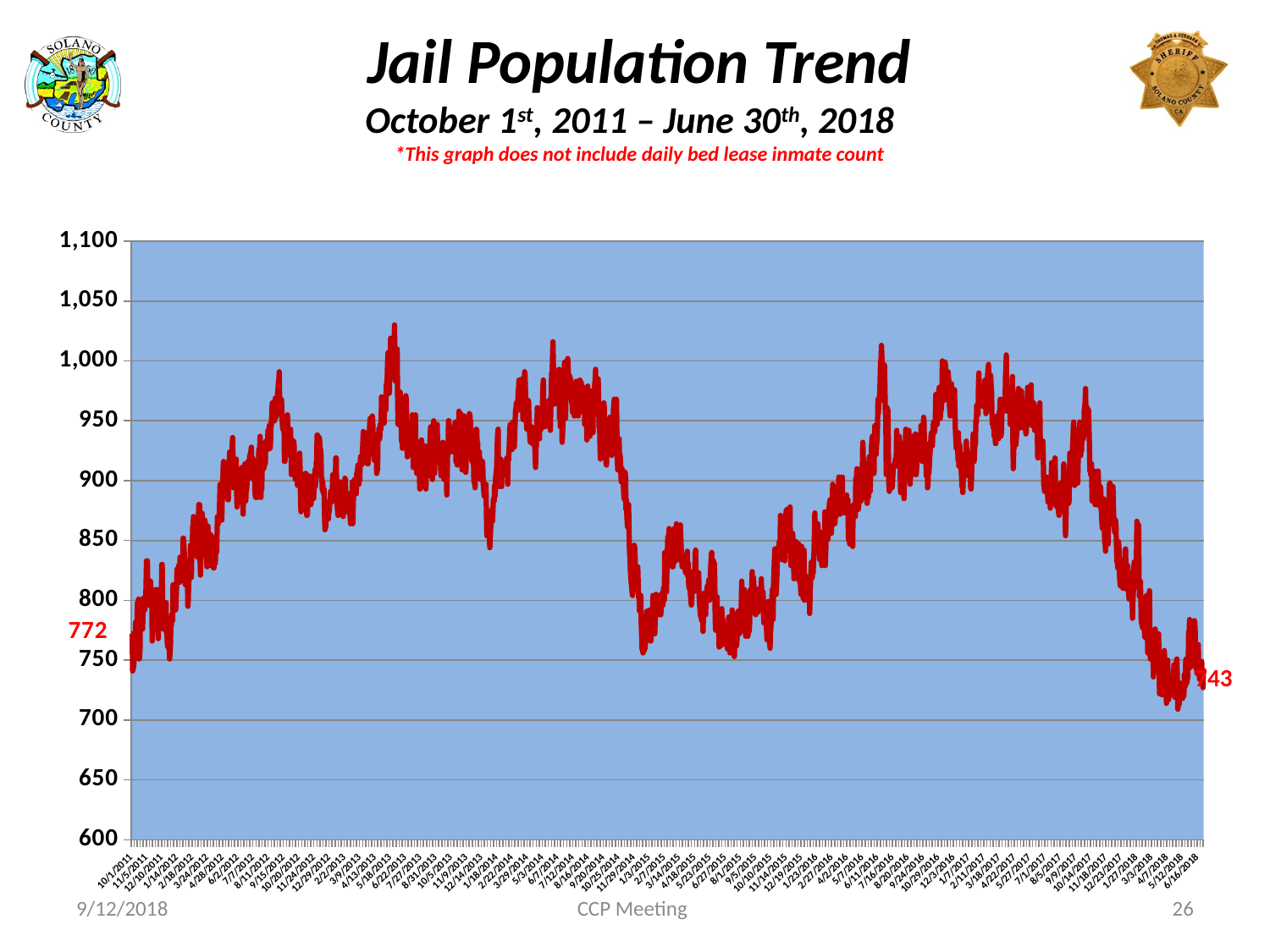
In which year does the line reach its highest point? 2013 Is the peak value around 6/22/2013 greater or less than 1,000? greater What is the highest value shown on the vertical axis? 1,100 Is the value around 4/7/2018 greater or less than 750? less What kind of chart is shown on the slide? line chart In which year does the line reach its lowest point? 2018 Does the jail population rise or fall over the final year of the chart (mid-2017 to June 2018)? fall What is the jail population value labelled at the start of the line (10/1/2011)? 772 Is the value around 1/3/2015 greater or less than 800? less What is the title of the chart? Jail Population Trend